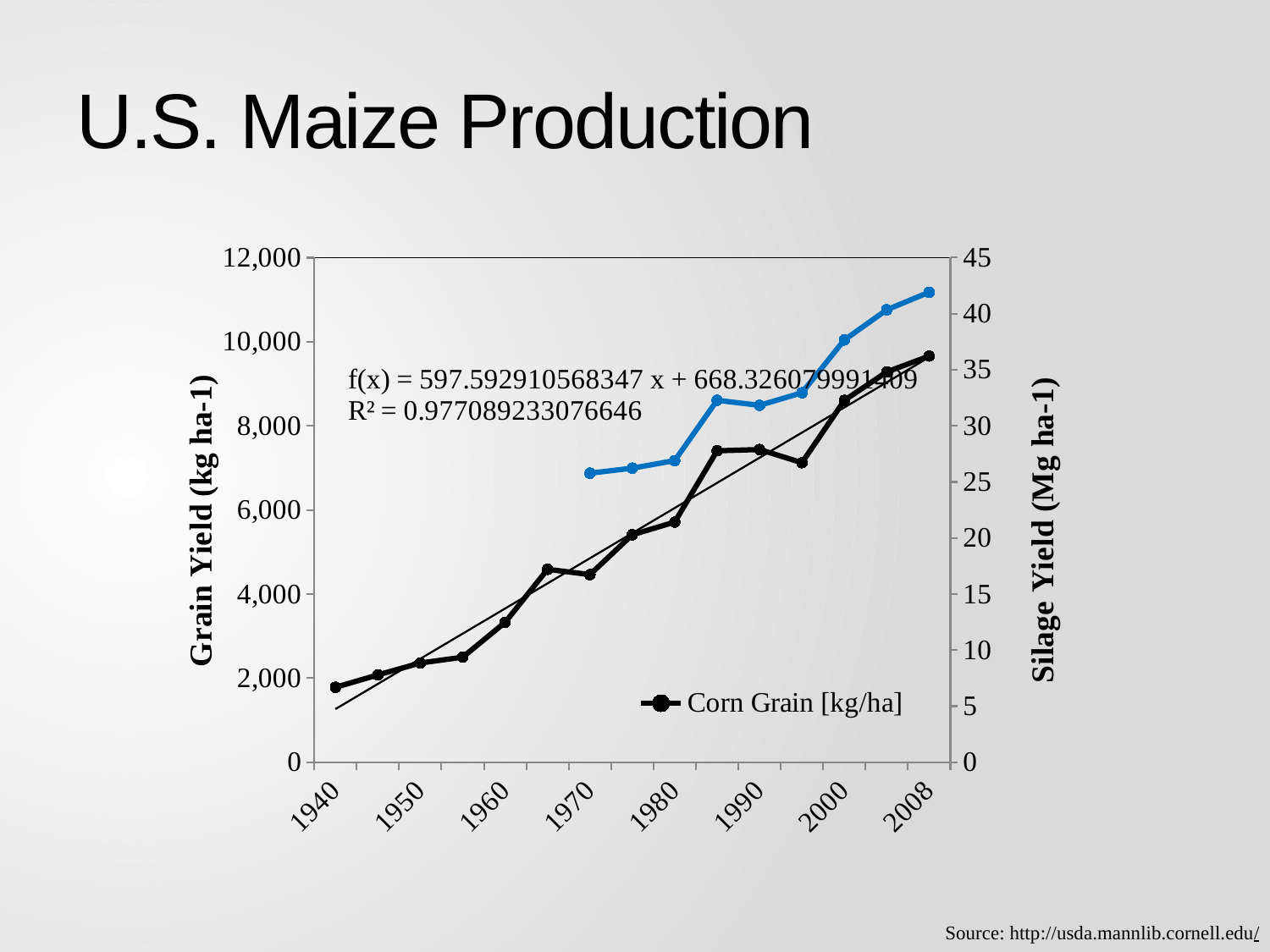
Is the Corn Grain [kg/ha] value for 1970 greater or less than 4,000? greater In which year is the Corn Grain [kg/ha] value highest? 2008 Is the Corn Grain [kg/ha] value for 1960 greater or less than 4,000? less Is the Corn Grain [kg/ha] value for 2008 greater or less than 8,000? greater What is the title of the slide's chart? U.S. Maize Production What kind of chart is shown on the slide? line chart Which year has the larger Corn Grain [kg/ha] value, 1990 or 2000? 2000 How many series does the chart's legend list? 1 Does the Corn Grain [kg/ha] series generally rise or fall from 1940 to 2008? rise In which year is the Corn Grain [kg/ha] value lowest? 1940 What is the R² value printed on the chart? 0.977089233076646